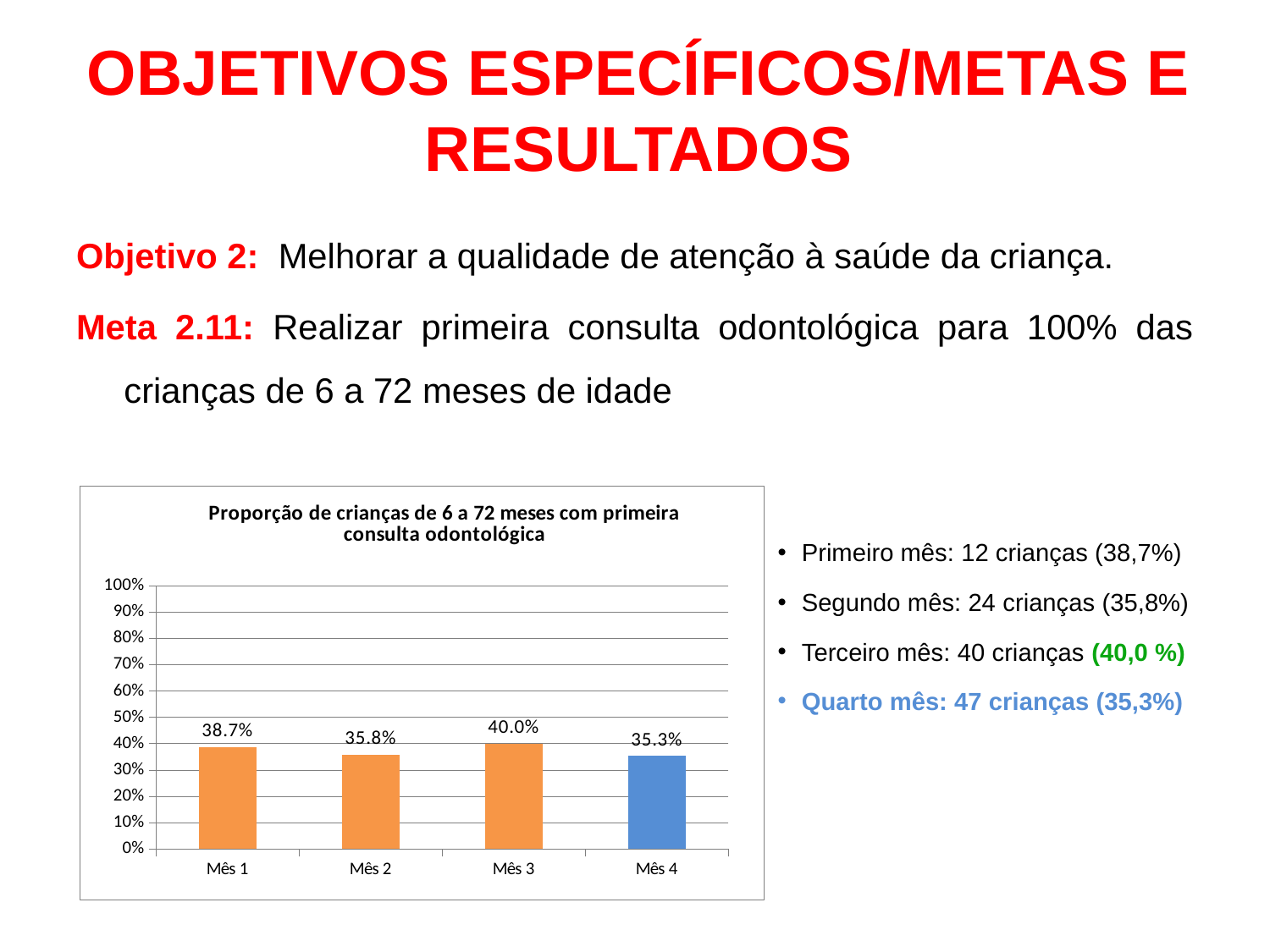
Is the value for Mês 3 greater or less than 50%? less What is the value for Mês 3? 40.0% Which is larger, the value for Mês 1 or the value for Mês 2? Mês 1 Which month has the highest value? Mês 3 What kind of chart is shown on the slide? bar chart Which month has the lowest value? Mês 4 Which bar is coloured differently from the others? Mês 4 What is the value for Mês 1? 38.7% What is the value for Mês 4? 35.3% What is the difference between the values for Mês 3 and Mês 2? 4.2% How many months are shown on the x axis? 4 What is the title of the chart? Proporção de crianças de 6 a 72 meses com primeira consulta odontológica